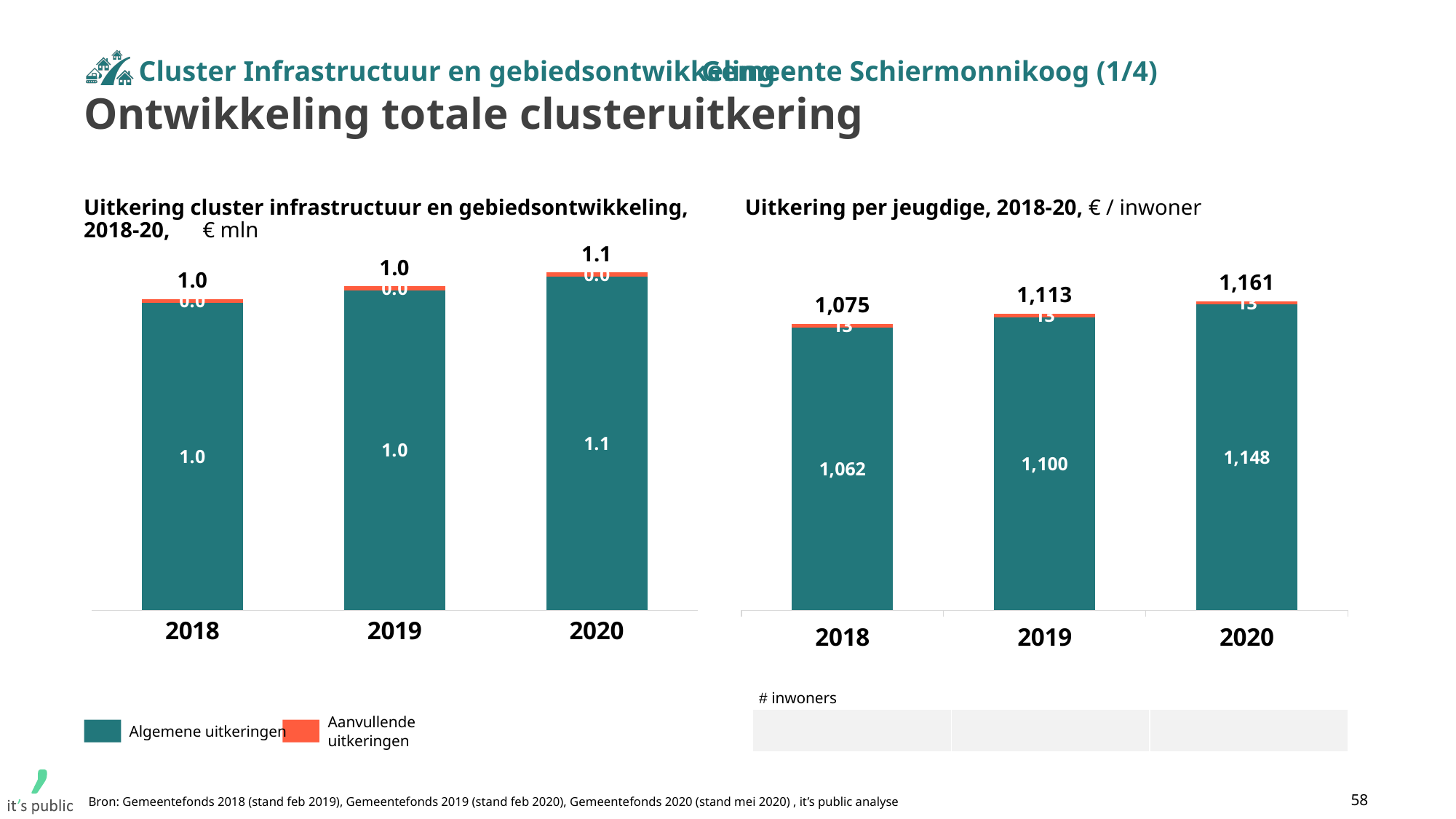
In the right chart (Uitkering per jeugdige), what is the Algemene uitkeringen value for 2018? 1,062 In the right chart (Uitkering per jeugdige), which year has the highest total? 2020 How many series does the legend list? 2 In the left chart (Uitkering cluster infrastructuur en gebiedsontwikkeling), what is the total value for 2020? 1.1 In the right chart (Uitkering per jeugdige), is the total for 2019 larger or smaller than the total for 2018? larger In the right chart (Uitkering per jeugdige), what is the total value for 2020? 1,161 In the right chart (Uitkering per jeugdige), what is the difference between the total for 2020 and the total for 2018? 86 How many years are shown on the x axis of the left chart? 3 What type of chart is the left chart (Uitkering cluster infrastructuur en gebiedsontwikkeling)? Stacked bar chart In the right chart (Uitkering per jeugdige), what is the difference between the Algemene uitkeringen values for 2019 and 2018? 38 In the right chart (Uitkering per jeugdige), which year has the lowest total? 2018 In the right chart (Uitkering per jeugdige), what is the Algemene uitkeringen value for 2019? 1,100